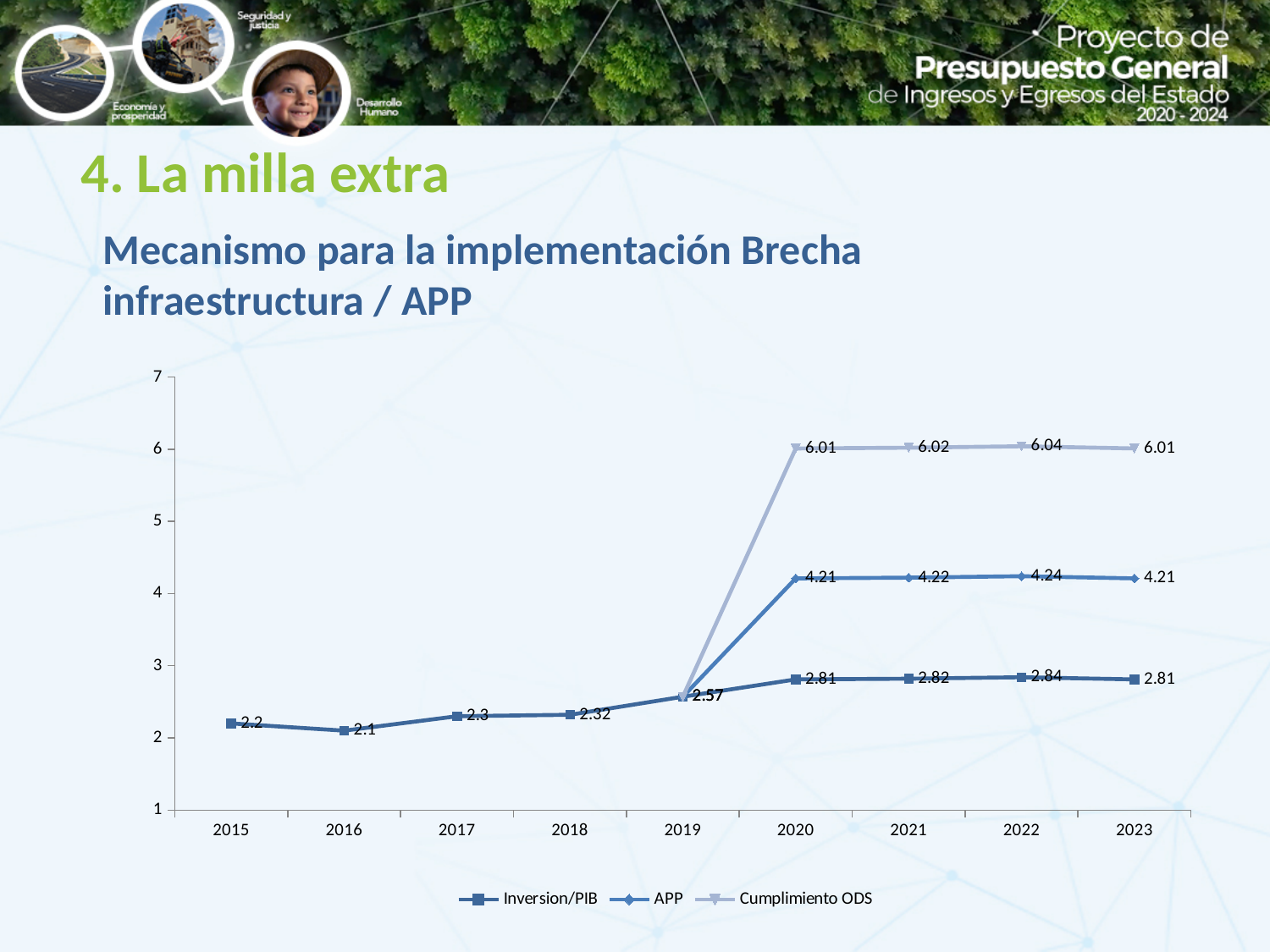
What is the value of Cumplimiento ODS in 2022? 6.04 What kind of chart is shown on the slide? line chart In which year is Inversion/PIB lowest? 2016 How many years are shown on the x axis? 9 What is the value of Inversion/PIB in 2016? 2.1 What is the value of APP in 2021? 4.22 In which year is Cumplimiento ODS highest? 2022 How many series does the legend list? 3 Does Inversion/PIB rise or fall between 2016 and 2020? rise Which series is shown with the lightest line colour in the legend? Cumplimiento ODS Which is larger in 2023, the APP value or the Inversion/PIB value? APP What is the difference between the Cumplimiento ODS value and the APP value in 2020? 1.8